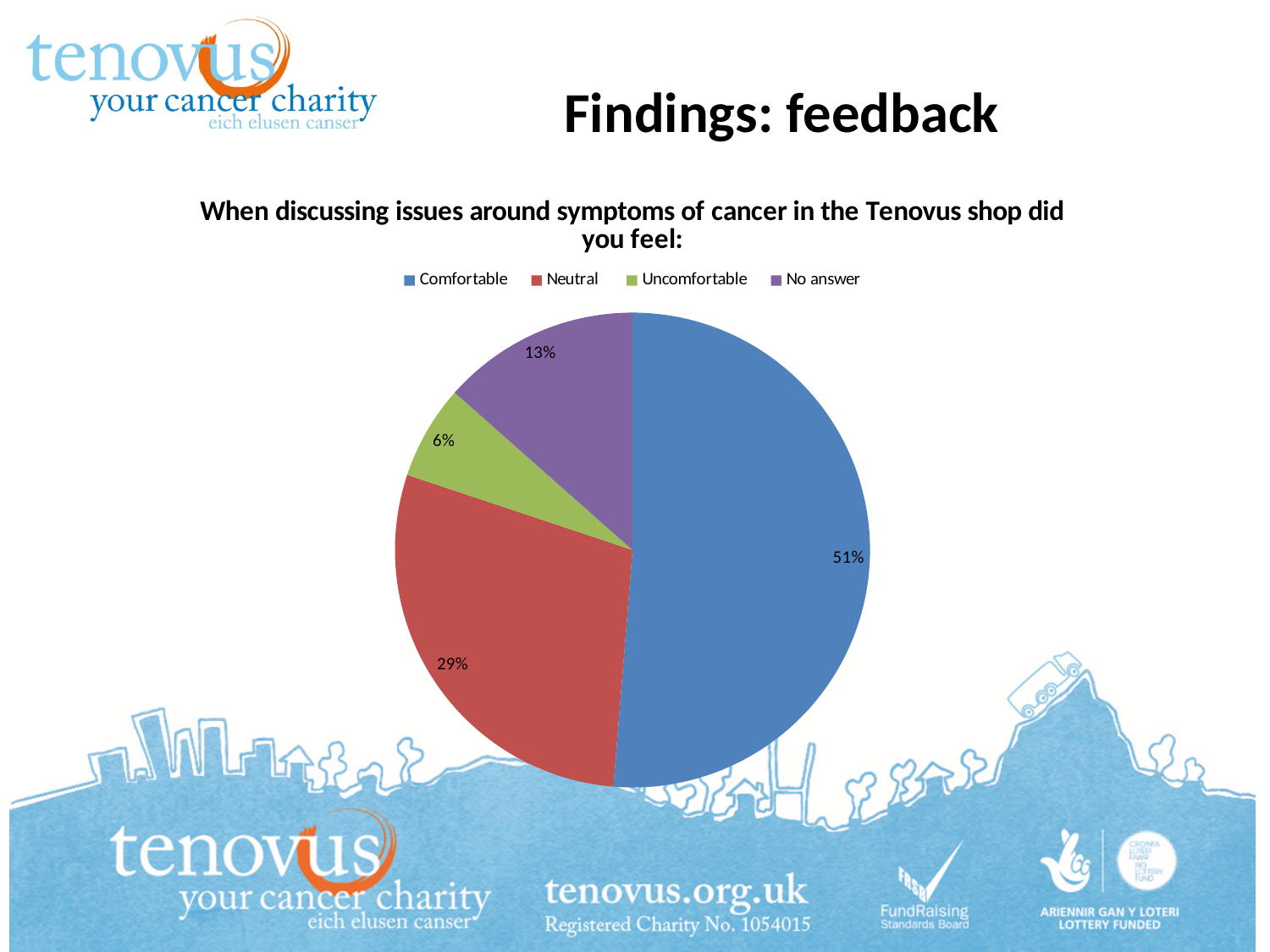
Which response has the largest share of the pie? Comfortable Which is larger, the share for No answer or the share for Uncomfortable? No answer What percentage of respondents gave No answer? 13% What kind of chart is shown on the slide? Pie chart What colour represents the Neutral slice? Red What is the title of the chart? When discussing issues around symptoms of cancer in the Tenovus shop did you feel: How many categories does the pie chart show? 4 What percentage of respondents said they felt Uncomfortable? 6% Which response has the smallest share of the pie? Uncomfortable What is the difference in percentage points between Comfortable and Neutral? 22 What percentage of respondents said they felt Comfortable? 51% What percentage of respondents said they felt Neutral? 29%